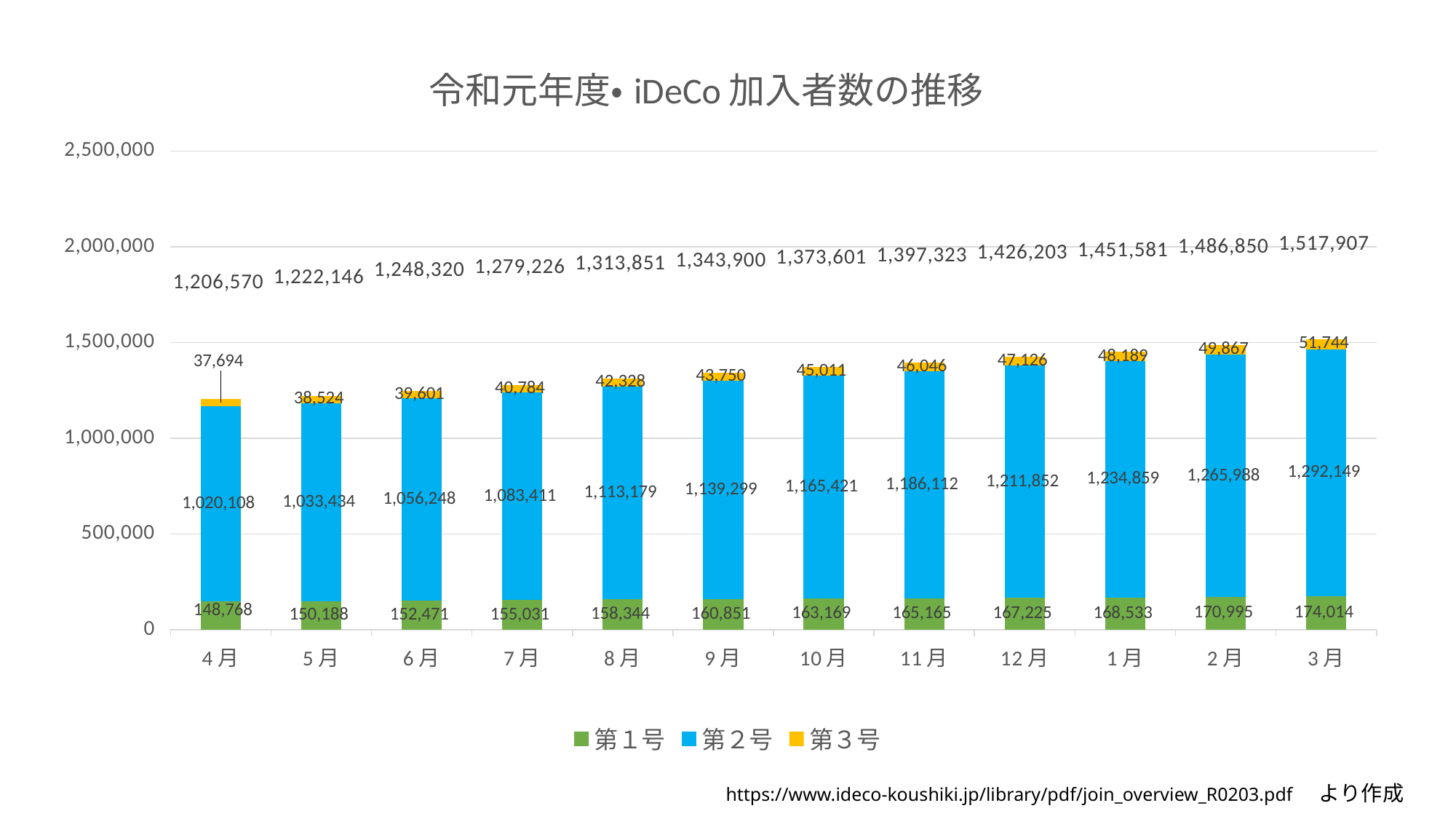
What is the value of 第３号 for 10月? 45,011 What is the title of the chart? 令和元年度• iDeCo 加入者数の推移 What is the total of the stacked bar for 3月? 1,517,907 How many months are shown on the x axis? 12 Which month has the lowest total number of subscribers? 4月 How many series does the legend list? 3 Do the total values rise or fall from 4月 to 3月? Rise What is the value of 第１号 for 3月? 174,014 What is the difference between the 第２号 value for 3月 and for 4月? 272,041 What is the value of 第２号 for 4月? 1,020,108 Which month has the highest value for 第２号? 3月 What type of chart is shown on the slide? Stacked bar chart